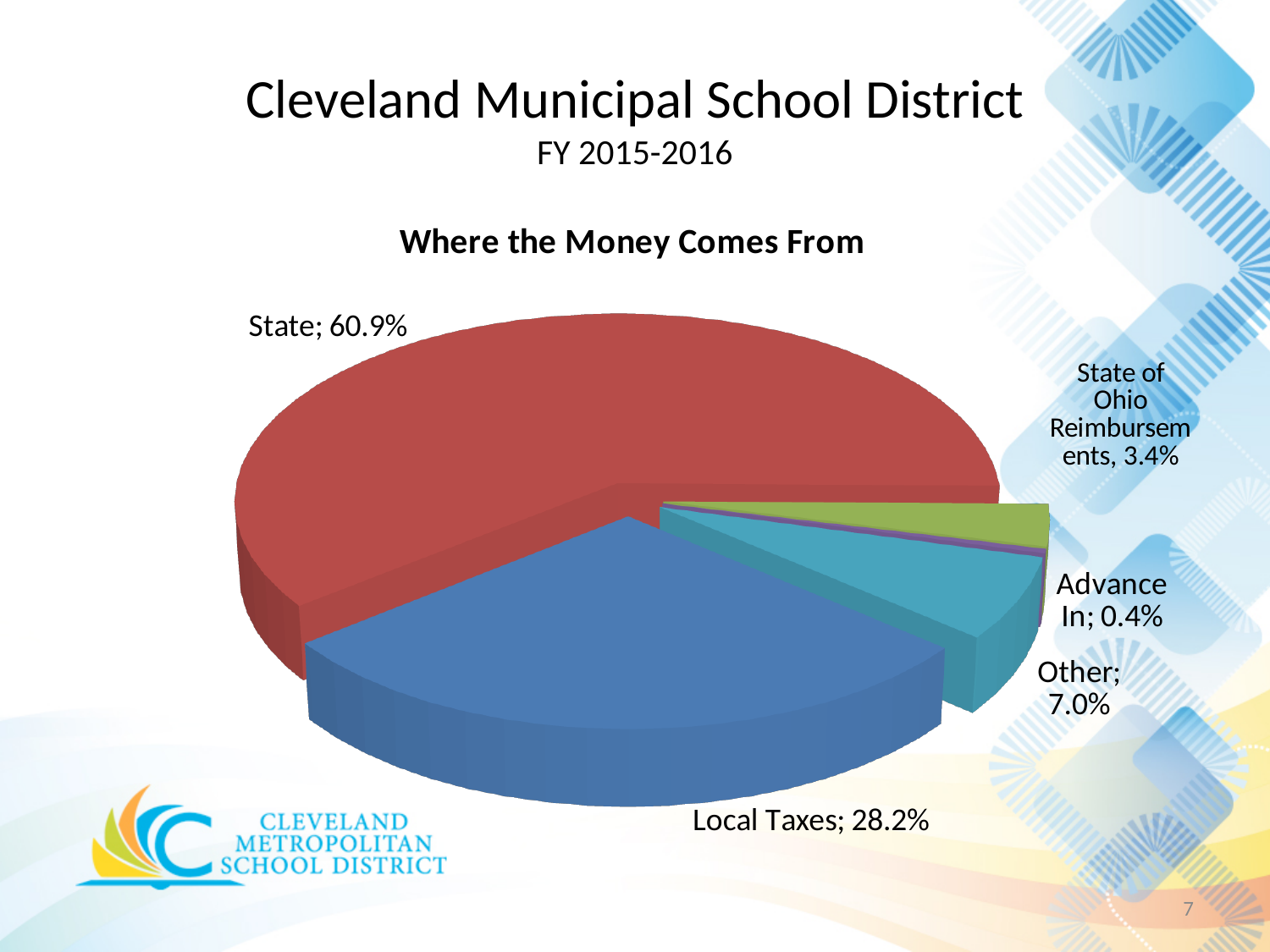
What is the difference in percentage points between State and Local Taxes? 32.7 What share of the pie does State of Ohio Reimbursements represent? 3.4% Which category has the largest slice of the pie? State What share of the pie does Advance In represent? 0.4% What is the title of the chart? Where the Money Comes From Which is larger, Other or State of Ohio Reimbursements? Other What share of the pie does Other represent? 7.0% How many categories are shown in the pie chart? 5 What kind of chart is shown on the slide? Pie chart Which category has the smallest slice of the pie? Advance In What share of the pie does State represent? 60.9% What share of the pie does Local Taxes represent? 28.2%